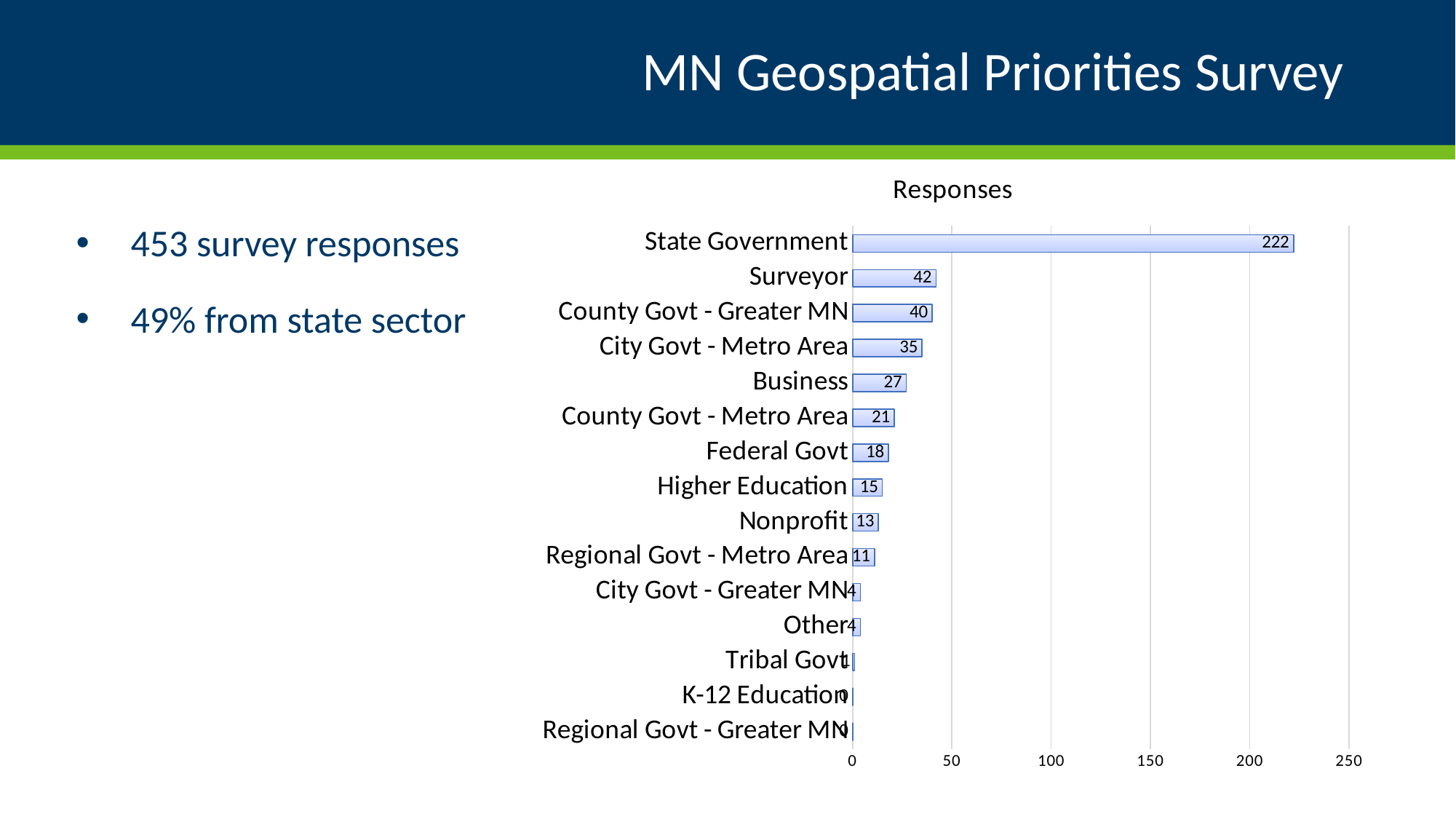
What is the value for Business? 27 How many categories are shown in the Responses chart? 15 Which is larger, the value for Federal Govt or the value for Nonprofit? Federal Govt What kind of chart is shown on the slide? Bar chart How many responses does the Surveyor category show? 42 What is the value for Higher Education? 15 What is the difference between the values for State Government and Surveyor? 180 Is the value for State Government greater or less than 200? greater What is the value for County Govt - Greater MN? 40 What is the difference between the values for Surveyor and City Govt - Metro Area? 7 What is the value for State Government in the Responses chart? 222 Which category has the highest number of responses? State Government